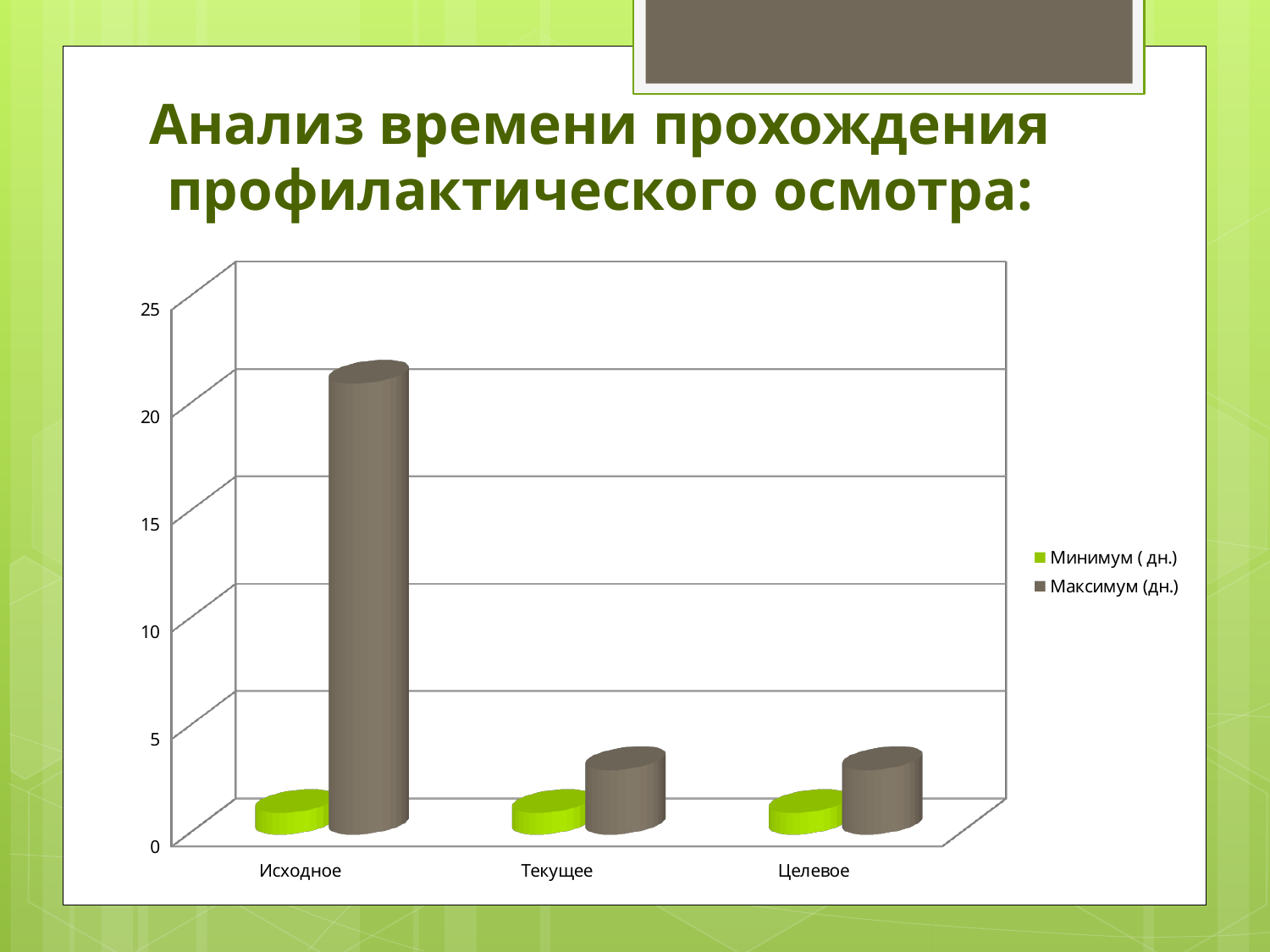
Is the Минимум ( дн.) value for Исходное greater or less than 5? less Which category has the highest value for the Максимум (дн.) series? Исходное What kind of chart is shown on the slide? bar chart How many series does the chart legend list? 2 What is the title of the slide containing the chart? Анализ времени прохождения профилактического осмотра: Is the Максимум (дн.) value for Исходное greater or less than 20? greater How many categories are shown on the x axis of the chart? 3 Is the Максимум (дн.) value for Текущее greater or less than 5? less Which is larger: the Максимум (дн.) value for Исходное or for Текущее? Исходное What are the two series names listed in the chart legend? Минимум ( дн.) and Максимум (дн.) Does the Максимум (дн.) series rise or fall from Исходное to Текущее? fall